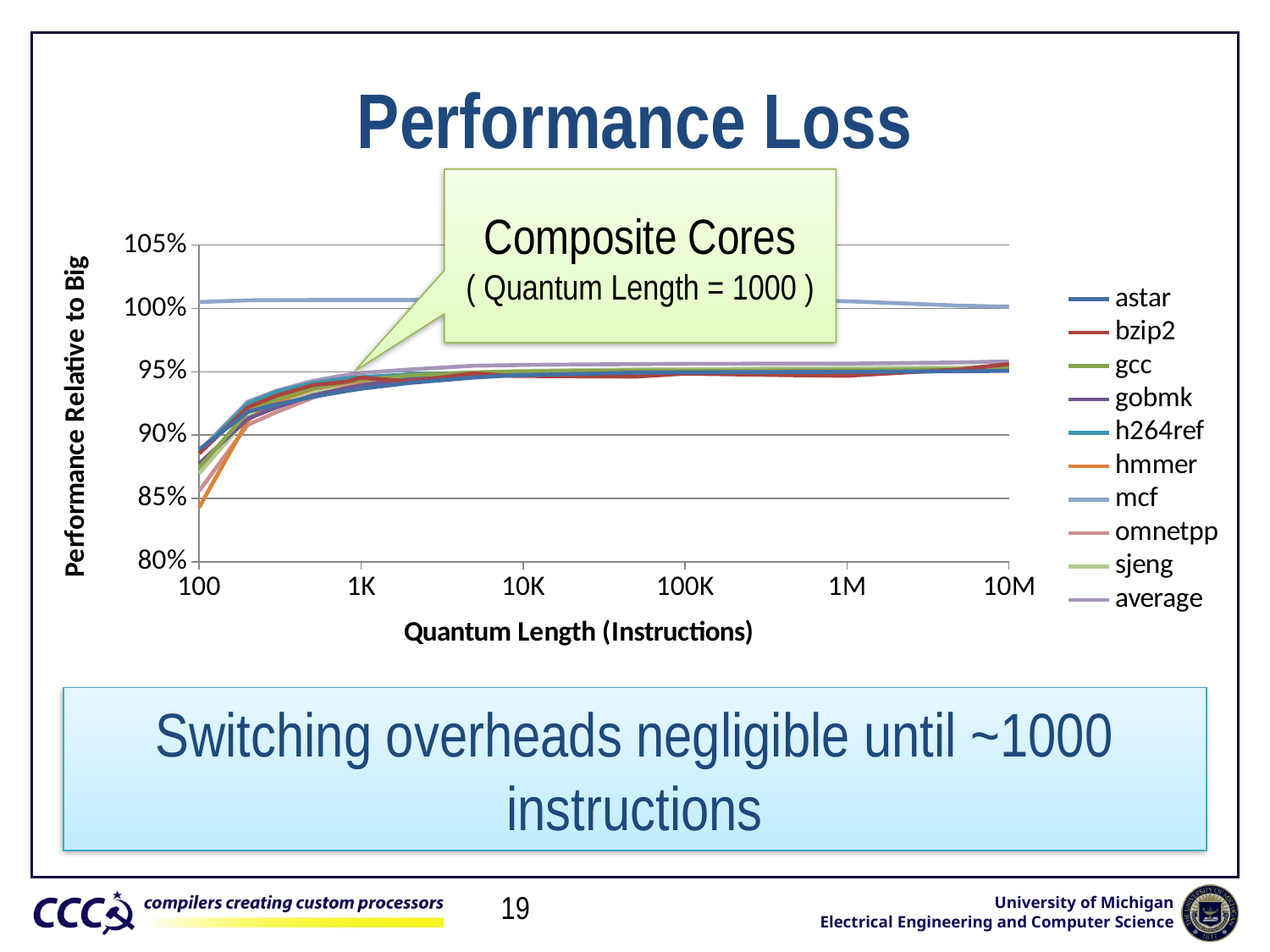
What is the title of the chart? Performance Loss How many series does the legend list? 10 Which series has the highest value at a quantum length of 100? mcf What is the label of the y axis? Performance Relative to Big Is the value for astar at a quantum length of 10K greater or less than 100%? less What kind of chart is shown on the slide? line chart Is the value for hmmer at a quantum length of 100 greater or less than 90%? less At a quantum length of 1K, which is larger, the value for mcf or the value for astar? mcf Which series has the lowest value at a quantum length of 100? hmmer How many tick labels are shown on the x axis? 6 Do the values for astar rise or fall as quantum length increases from 100 to 10K? rise Is the value for mcf at a quantum length of 1K greater or less than 95%? greater